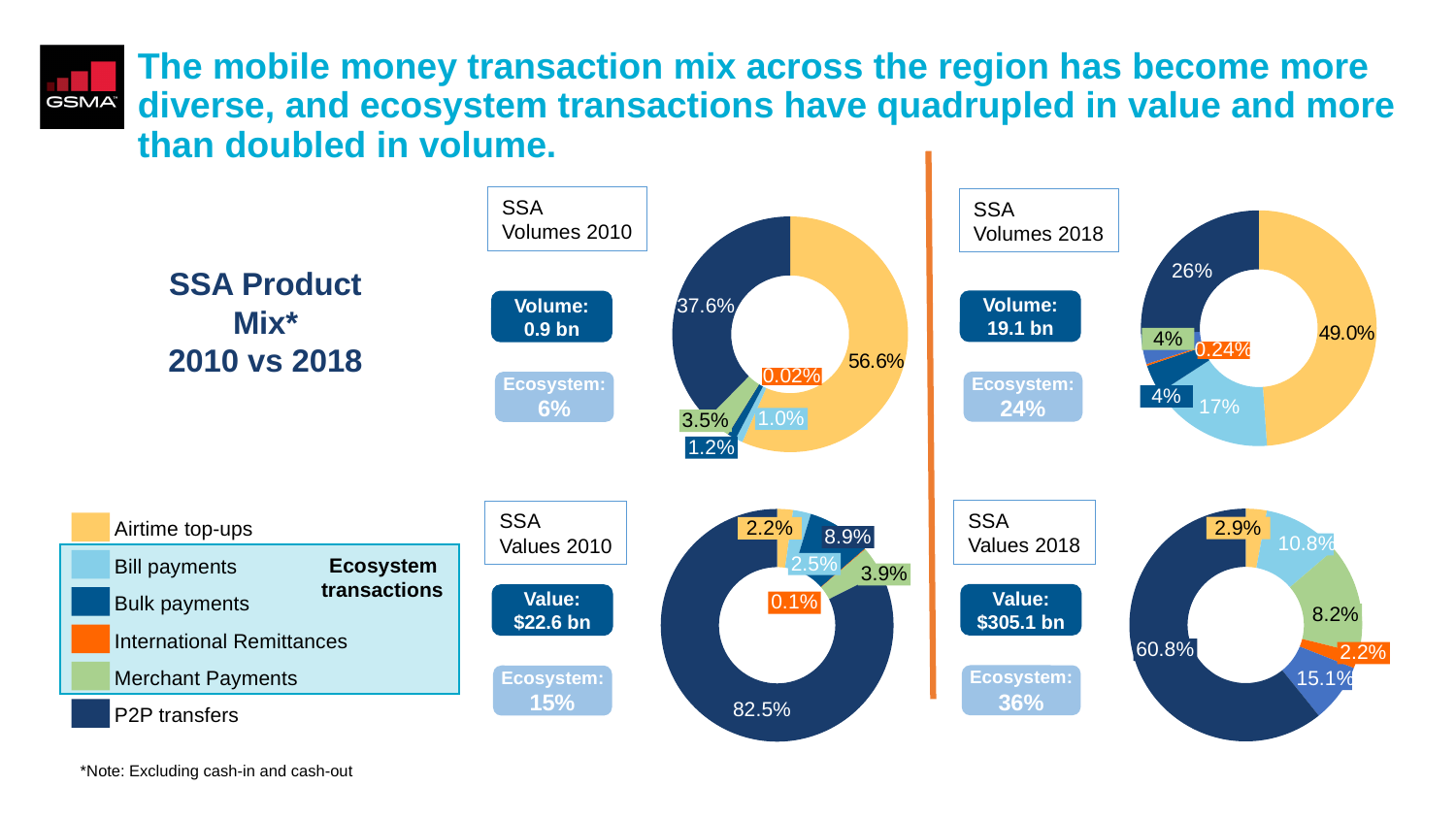
In the SSA Values 2018 chart, which is larger: Bill payments or Merchant Payments? Bill payments In the SSA Volumes 2010 chart, what share do P2P transfers have? 37.6% In the SSA Values 2018 chart, what share do Bulk payments have? 15.1% How many categories does the legend list? 6 In the SSA Volumes 2018 chart, what share do Bill payments have? 17% In the SSA Volumes 2010 chart, what share do Airtime top-ups have? 56.6% In the SSA Values 2010 chart, which category has the largest share? P2P transfers In the SSA Values 2018 chart, what share do P2P transfers have? 60.8% What kind of chart is used for SSA Volumes 2018? Donut (pie) chart What is the difference between the P2P transfers share in the SSA Values 2010 chart and in the SSA Values 2018 chart? 21.7 percentage points In the SSA Volumes 2010 chart, which category has the smallest share? International Remittances In the SSA Volumes 2018 chart, what share do Airtime top-ups have? 49.0%